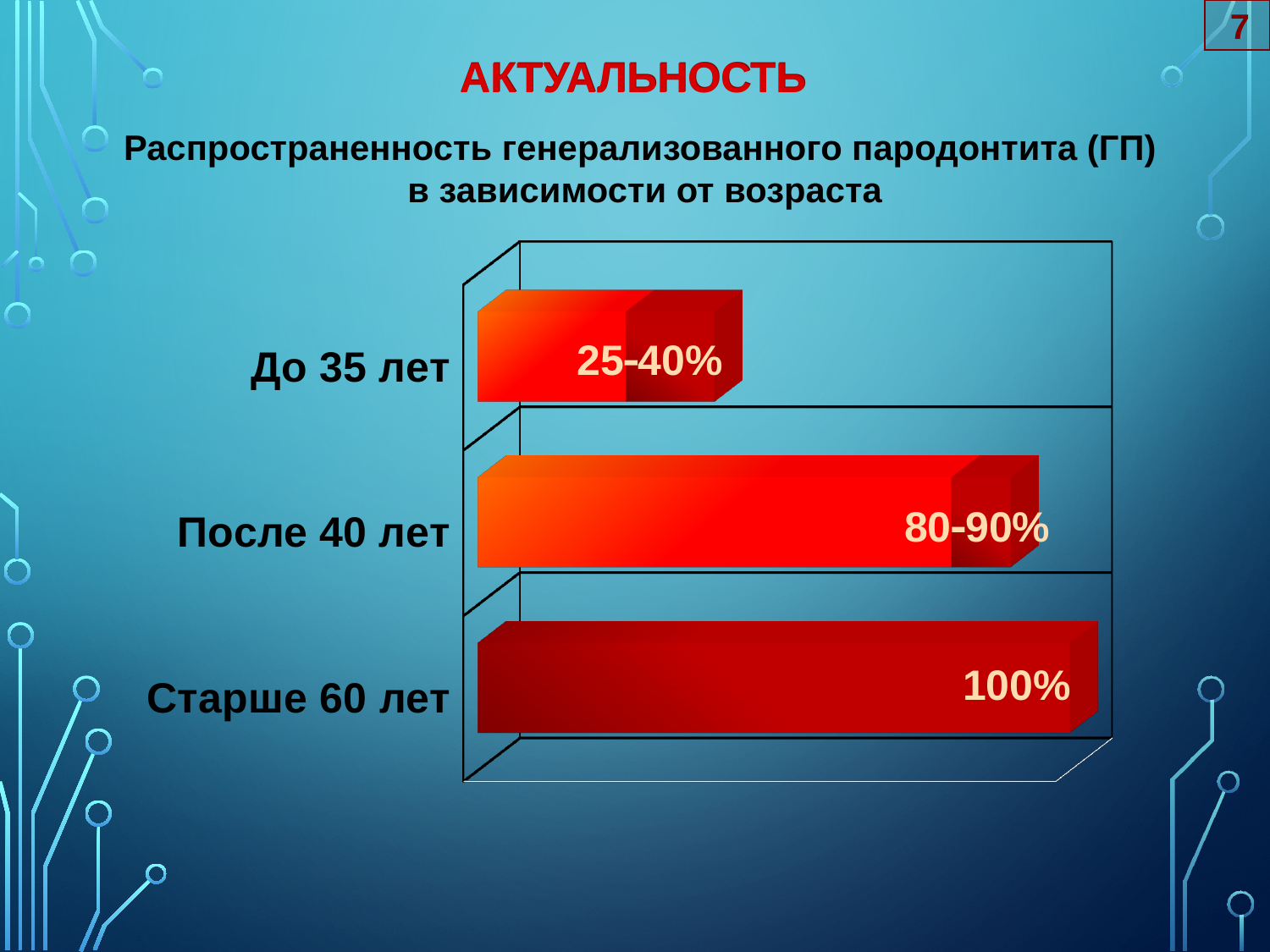
How many age categories are shown in the chart? 3 Do the values increase or decrease as age increases from 'До 35 лет' to 'Старше 60 лет'? Increase Which age category has the lowest prevalence? До 35 лет What kind of chart is shown on the slide? Bar chart Are the bars in the chart horizontal or vertical? Horizontal Which is larger, the value for 'До 35 лет' or for 'После 40 лет'? После 40 лет What value is shown for the 'До 35 лет' category? 25-40% What is the title of the chart on the slide? Распространенность генерализованного пародонтита (ГП) в зависимости от возраста Which age category has the highest prevalence? Старше 60 лет What value is shown for the 'Старше 60 лет' category? 100% What value is shown for the 'После 40 лет' category? 80-90%